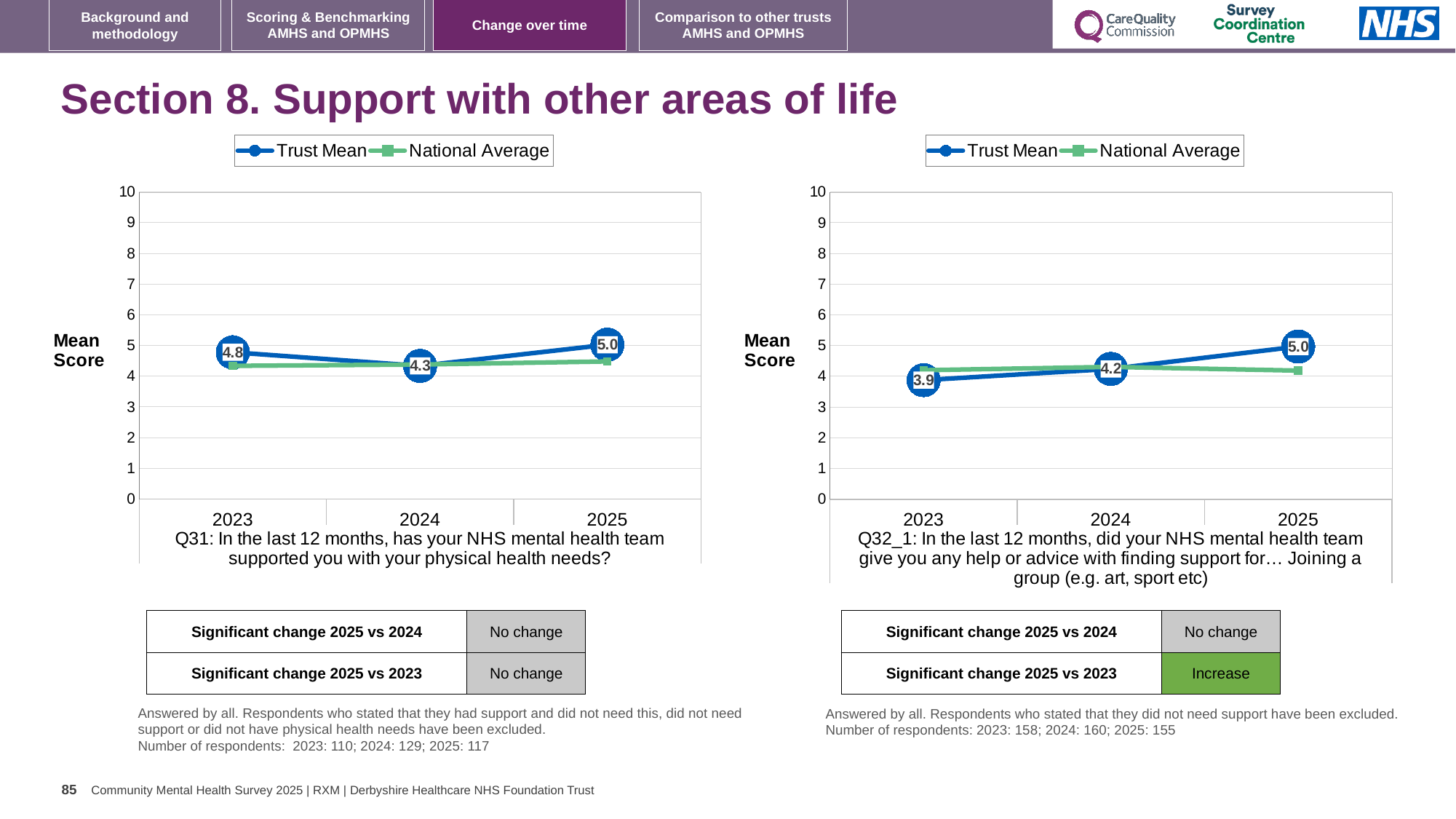
In the Q32_1 chart on the right, does the Trust Mean rise or fall from 2023 to 2025? Rise In the Q31 chart on the left, is the Trust Mean higher in 2023 or in 2024? 2023 In the Q31 chart on the left, what is the Trust Mean for 2024? 4.3 In the Q31 chart on the left, what is the Trust Mean for 2025? 5.0 In the Q31 chart on the left, which year has the lowest Trust Mean? 2024 In the Q32_1 chart on the right, what is the difference between the Trust Mean for 2025 and the Trust Mean for 2023? 1.1 How many series does the legend of the Q32_1 chart on the right list? 2 In the Q32_1 chart on the right, which year has the highest Trust Mean? 2025 What kind of chart is the Q31 chart on the left? Line chart In the Q32_1 chart on the right, what is the Trust Mean for 2023? 3.9 How many years are plotted on the x axis of the Q31 chart on the left? 3 In the Q32_1 chart on the right, is the National Average for 2025 greater or less than 5? less